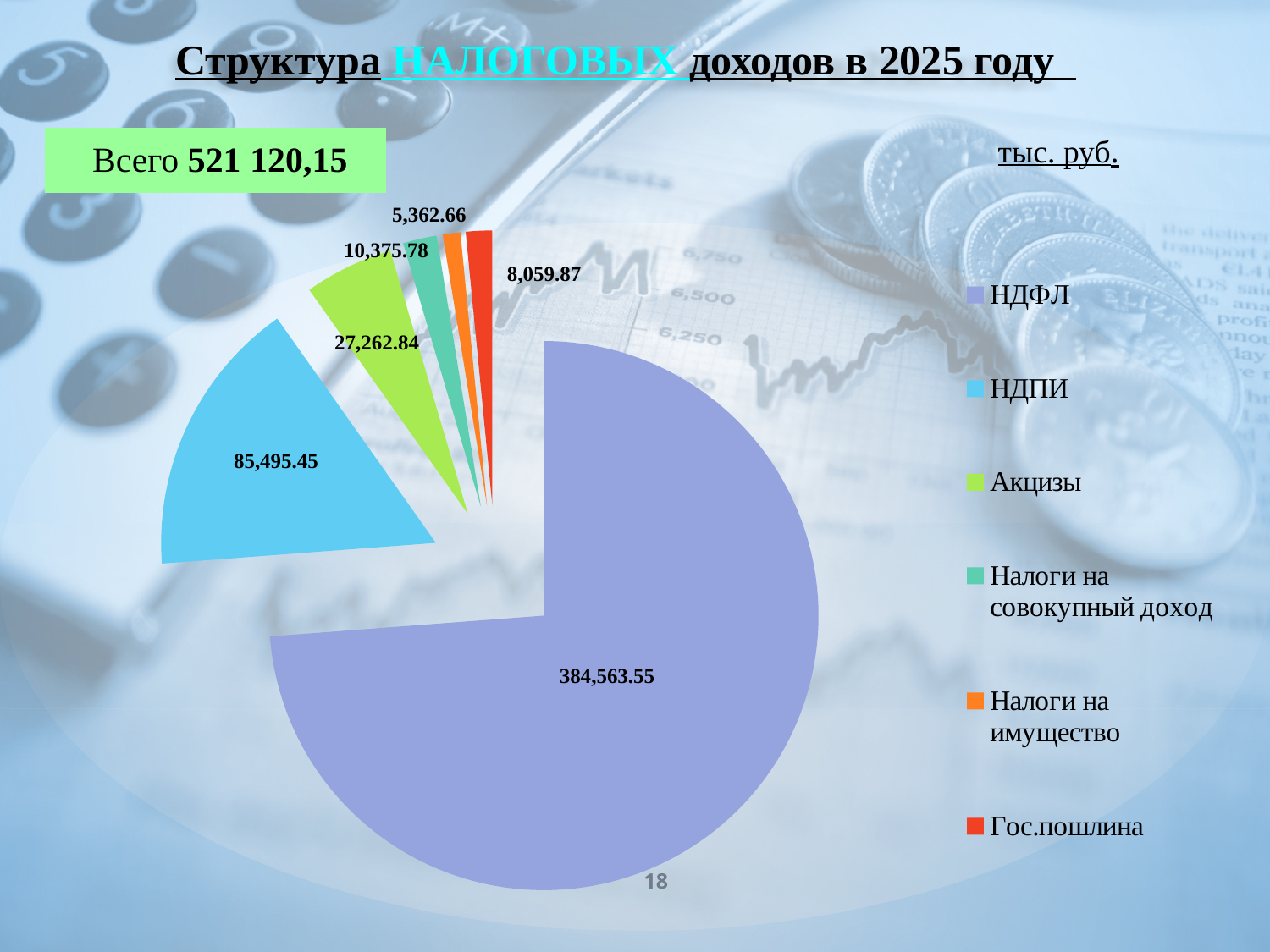
What type of chart is shown on the slide? Pie chart What is the difference between the values for НДПИ and Акцизы? 58,232.61 What is the value for НДПИ? 85,495.45 Which category has the largest slice of the pie? НДФЛ How many categories does the legend list? 6 What is the value for НДФЛ? 384,563.55 Which category has the smallest slice of the pie? Налоги на имущество What is the value for Налоги на совокупный доход? 10,375.78 What is the value for Акцизы? 27,262.84 Which is larger, Гос.пошлина or Налоги на имущество? Гос.пошлина What total is stated on the slide for all tax revenues? 521 120,15 What is the value for Гос.пошлина? 8,059.87